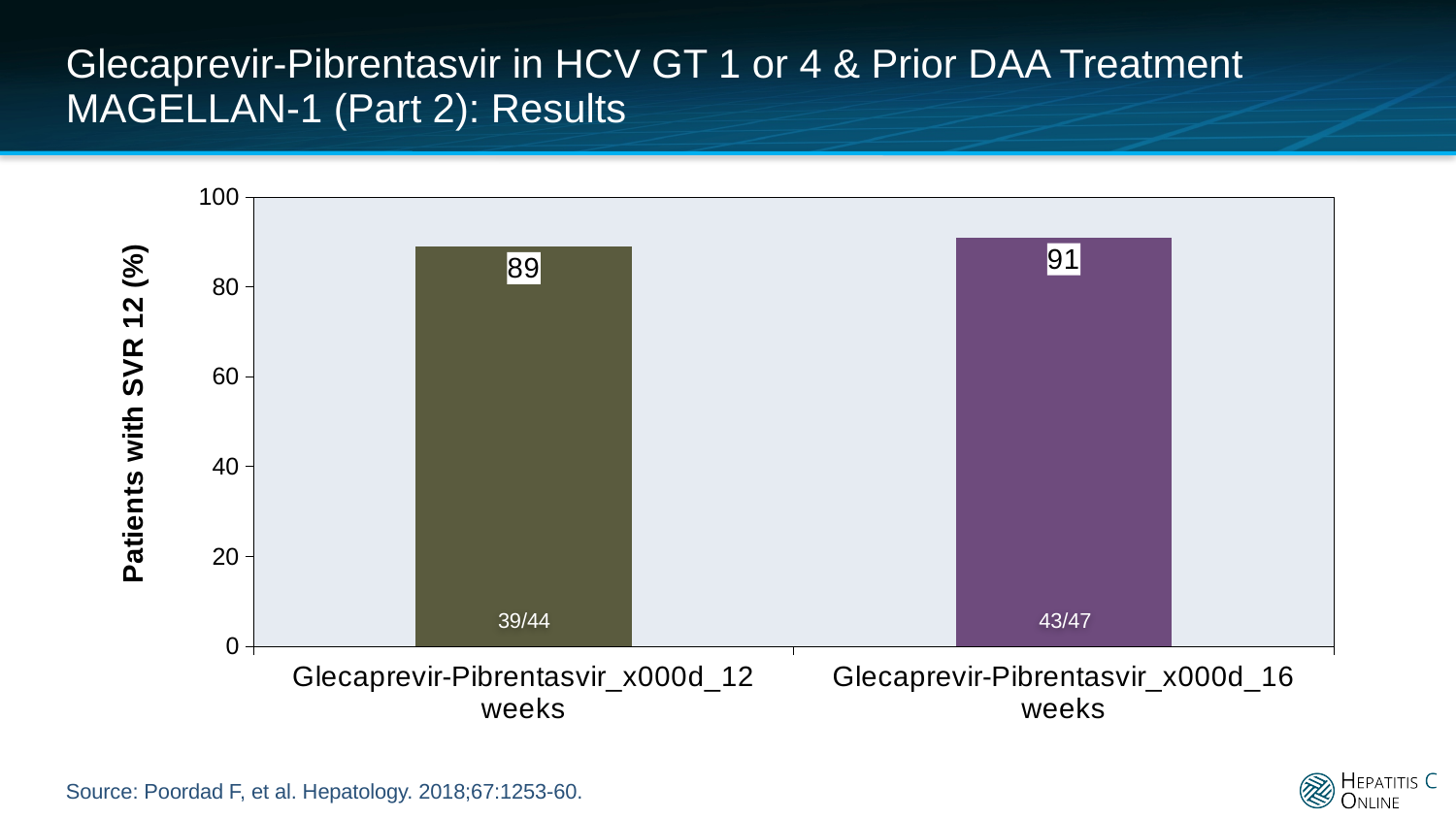
Is the SVR 12 rate for the 12-week arm greater or less than 80? greater What is the SVR 12 rate for Glecaprevir-Pibrentasvir 12 weeks? 89 What is the SVR 12 rate for Glecaprevir-Pibrentasvir 16 weeks? 91 What fraction of patients achieved SVR 12 in the 16-week arm? 43/47 What is the difference in SVR 12 rate between the 16-week and 12-week arms? 2 What fraction of patients achieved SVR 12 in the 12-week arm? 39/44 How many treatment arms are shown in the chart? 2 Which treatment arm has the lower SVR 12 rate? Glecaprevir-Pibrentasvir 12 weeks Is the SVR 12 rate for the 16-week arm greater or less than 100? less Which treatment arm has the higher SVR 12 rate? Glecaprevir-Pibrentasvir 16 weeks What kind of chart is shown on the slide? Bar chart What is the label of the y-axis? Patients with SVR 12 (%)